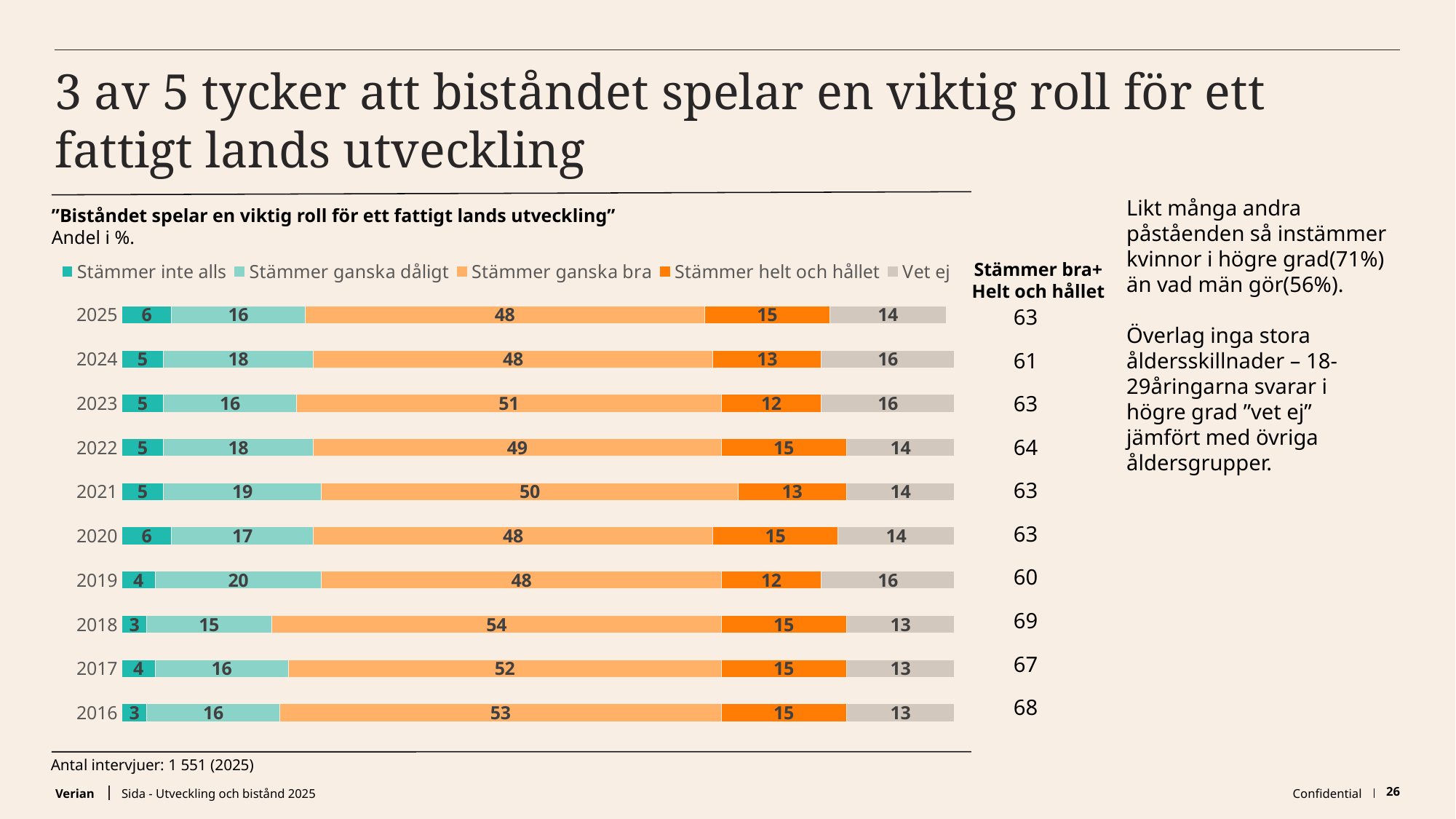
What is the value for "Stämmer ganska bra" in 2025? 48 How many years are shown in the chart? 10 What is the difference between "Stämmer ganska bra" and "Stämmer helt och hållet" in 2025? 33 What is the value for "Stämmer helt och hållet" in 2023? 12 What is the total of the stacked bar for 2025? 99 Which year has the larger value for "Stämmer ganska bra", 2023 or 2024? 2023 How many series does the legend list? 5 In which year is the value for "Stämmer ganska dåligt" highest? 2019 What is the value for "Vet ej" in 2024? 16 What is the "Stämmer bra+Helt och hållet" figure shown for 2018? 69 What kind of chart is shown on the slide? Stacked bar chart In which year is the value for "Stämmer ganska bra" highest? 2018